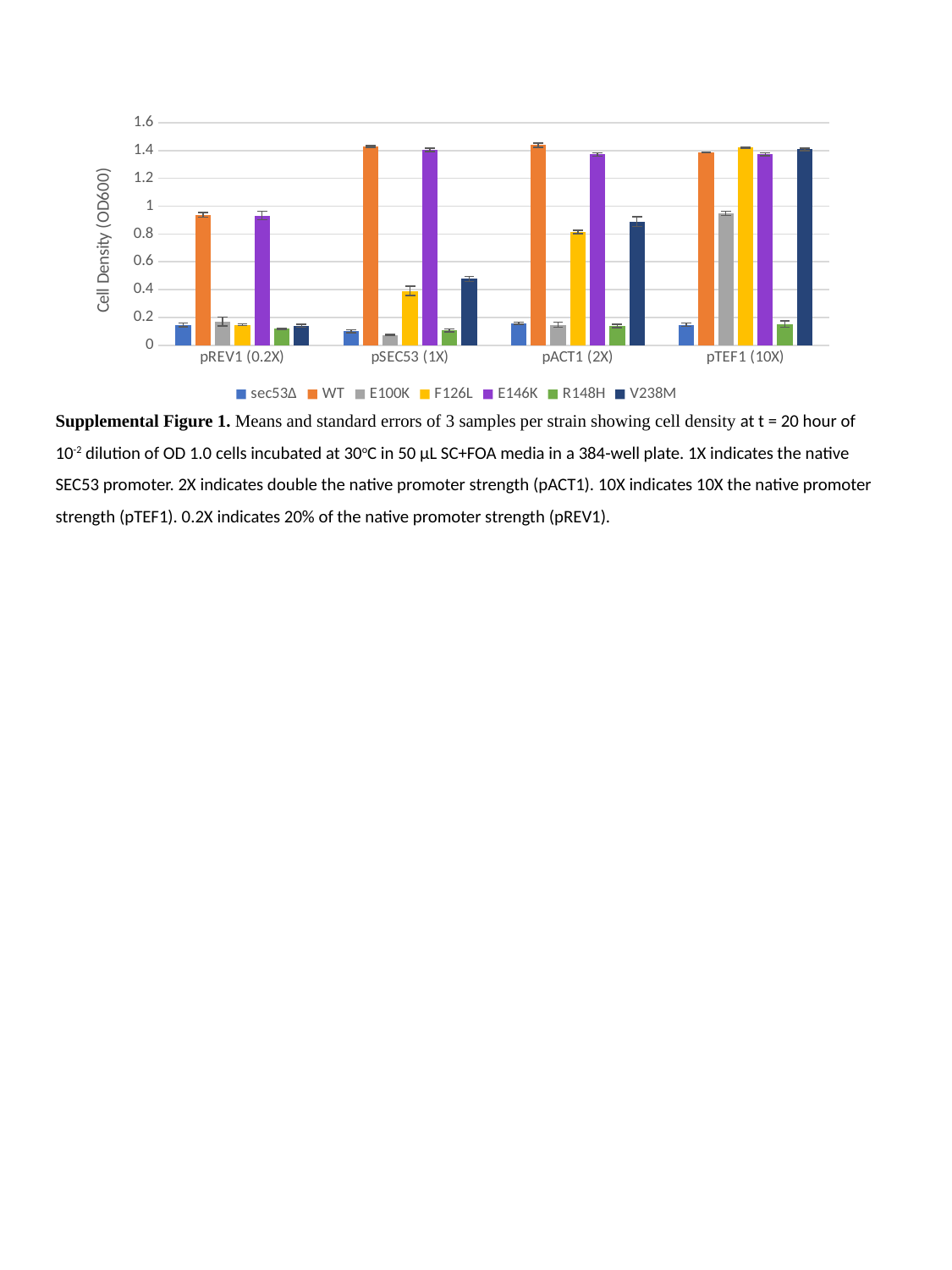
Is the value for WT at pSEC53 (1X) greater or less than 1.2? greater Is the value for WT at pREV1 (0.2X) greater or less than 1.0? less Is the value for F126L at pSEC53 (1X) greater or less than 0.6? less Do the V238M values rise or fall from pREV1 (0.2X) to pTEF1 (10X)? rise Which is larger: the E100K value at pTEF1 (10X) or the E100K value at pACT1 (2X)? pTEF1 (10X) What is the label of the y axis? Cell Density (OD600) What kind of chart is shown on the slide? bar chart How many series does the legend list? 7 How many promoter categories are shown on the x axis? 4 Which is larger: the F126L value at pACT1 (2X) or the F126L value at pSEC53 (1X)? pACT1 (2X)